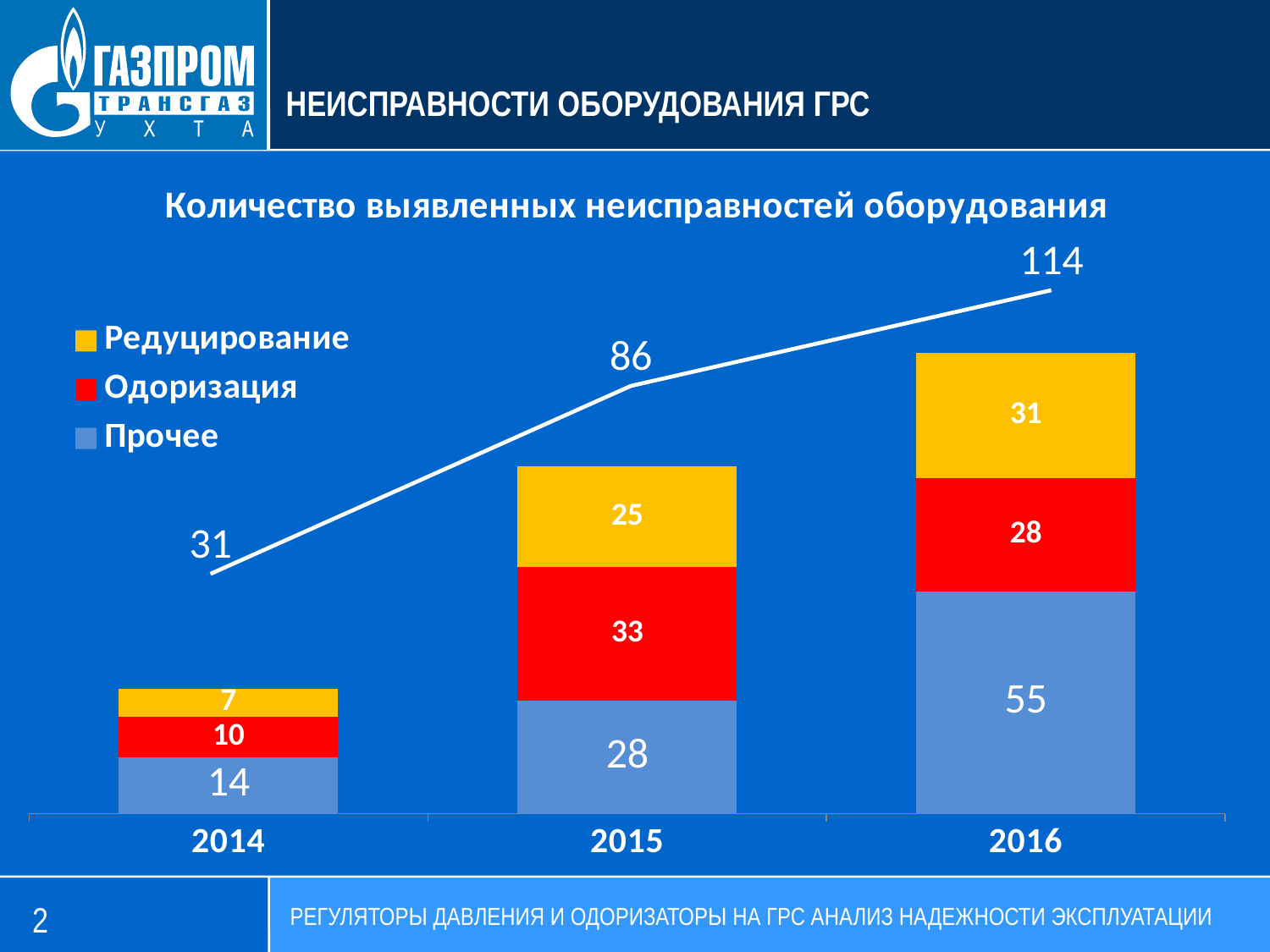
Which year has the lowest value for Прочее? 2014 How many series does the legend list? 3 Do the total values rise or fall from 2014 to 2016? rise What is the value for Одоризация in 2015? 33 How many years are shown on the x axis? 3 What is the value for Редуцирование in 2014? 7 Which year has the highest total number of faults? 2016 Which is larger in 2016: Редуцирование or Одоризация? Редуцирование What is the total number of faults shown for 2016? 114 What is the difference between the totals for 2015 and 2014? 55 What is the total of the stacked bar for 2014? 31 What is the value for Прочее in 2016? 55